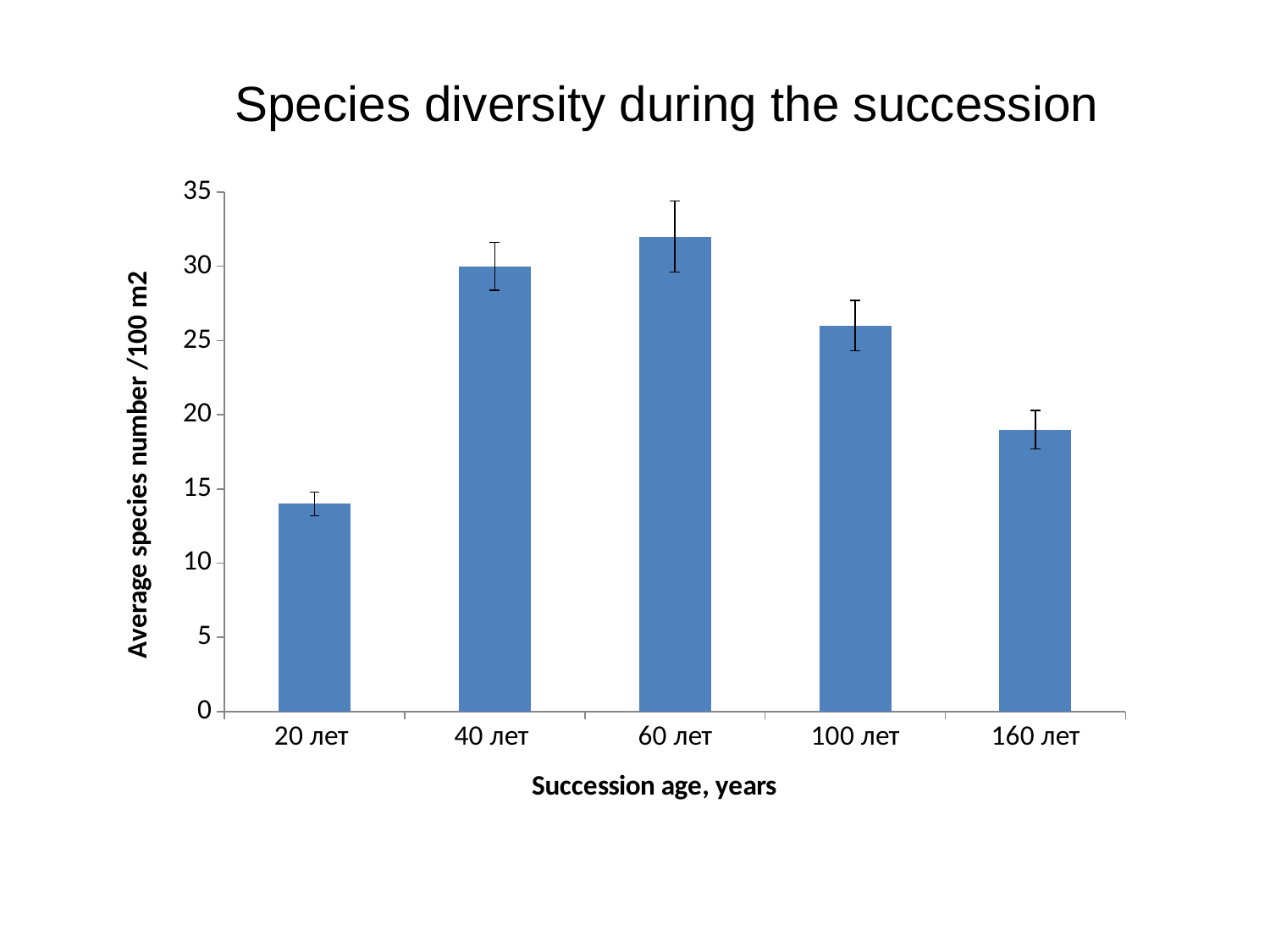
How do the values change from 60 лет to 160 лет along the x axis? they fall Is the value for 60 лет greater or less than 30? greater Is the value for 20 лет greater or less than 15? less Is the value for 160 лет greater or less than 20? less How many succession age categories are shown on the x axis? 5 Which succession age has the highest average species number? 60 лет Which has a larger average species number, 40 лет or 100 лет? 40 лет What kind of chart is shown on the slide? bar chart Which succession age has the lowest average species number? 20 лет What is the label of the y axis? Average species number /100 m2 Which has a larger average species number, 160 лет or 20 лет? 160 лет